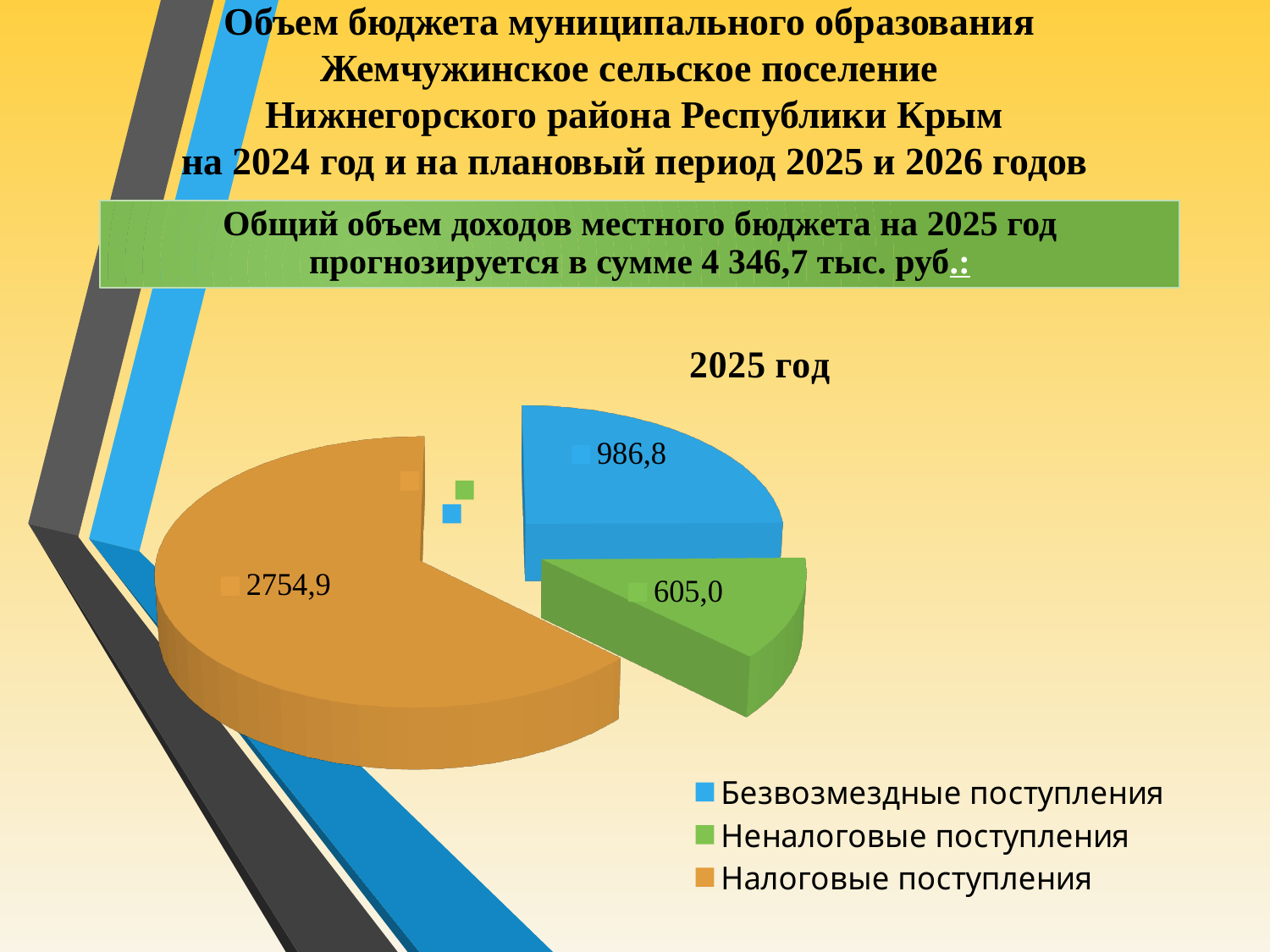
What is the value for Безвозмездные поступления? 986,8 What is the value for Налоговые поступления? 2754,9 How many entries does the legend list? 3 Which category has the largest slice of the pie? Налоговые поступления What is the title of the chart? 2025 год What colour is the slice for Неналоговые поступления? green What type of chart is shown on the slide? pie chart Which is larger, Безвозмездные поступления or Неналоговые поступления? Безвозмездные поступления What is the value for Неналоговые поступления? 605,0 Which category has the smallest slice of the pie? Неналоговые поступления What is the difference between Налоговые поступления and Безвозмездные поступления? 1768,1 How many slices does the pie chart have? 3